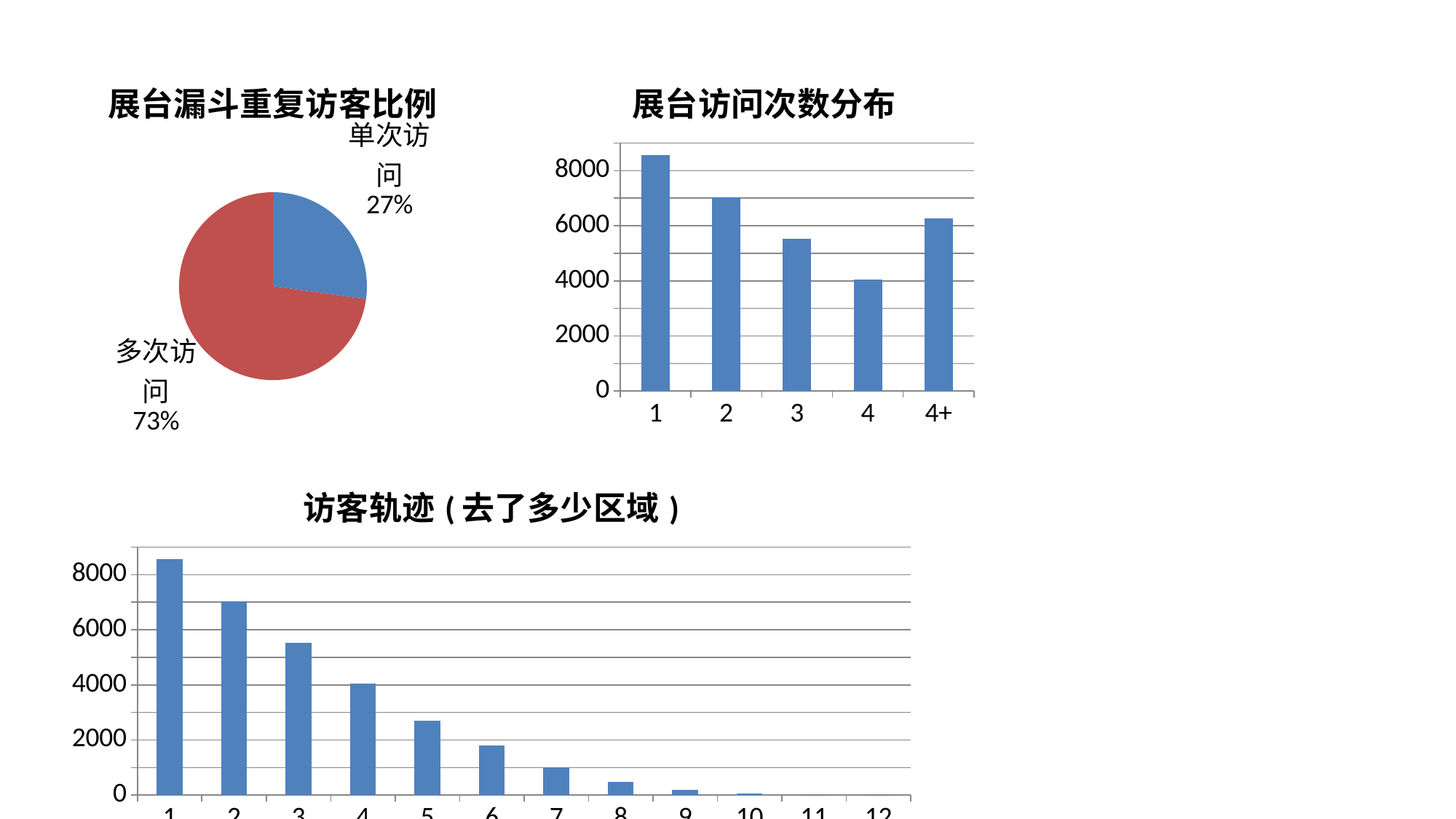
In the chart titled 访客轨迹（去了多少区域）, do the values rise or fall as you move from category 1 to category 12? Fall In the chart titled 展台漏斗重复访客比例, what share of the pie is 单次访问? 27% In the chart titled 展台访问次数分布, which category has the lowest value? 4 What kind of chart is the one titled 展台漏斗重复访客比例? Pie chart In the chart titled 展台访问次数分布, how many categories are shown on the x axis? 5 In the chart titled 展台漏斗重复访客比例, which slice is larger, 单次访问 or 多次访问? 多次访问 In the chart titled 展台访问次数分布, which category has the highest value? 1 In the chart titled 展台漏斗重复访客比例, what share of the pie is 多次访问? 73% In the chart titled 访客轨迹（去了多少区域）, is the value for category 5 greater or less than 2000? greater In the chart titled 访客轨迹（去了多少区域）, how many categories are shown on the x axis? 12 In the chart titled 展台访问次数分布, is the value for category 1 greater or less than 8000? greater In the chart titled 展台访问次数分布, which is larger, the value for 3 or the value for 4+? 4+